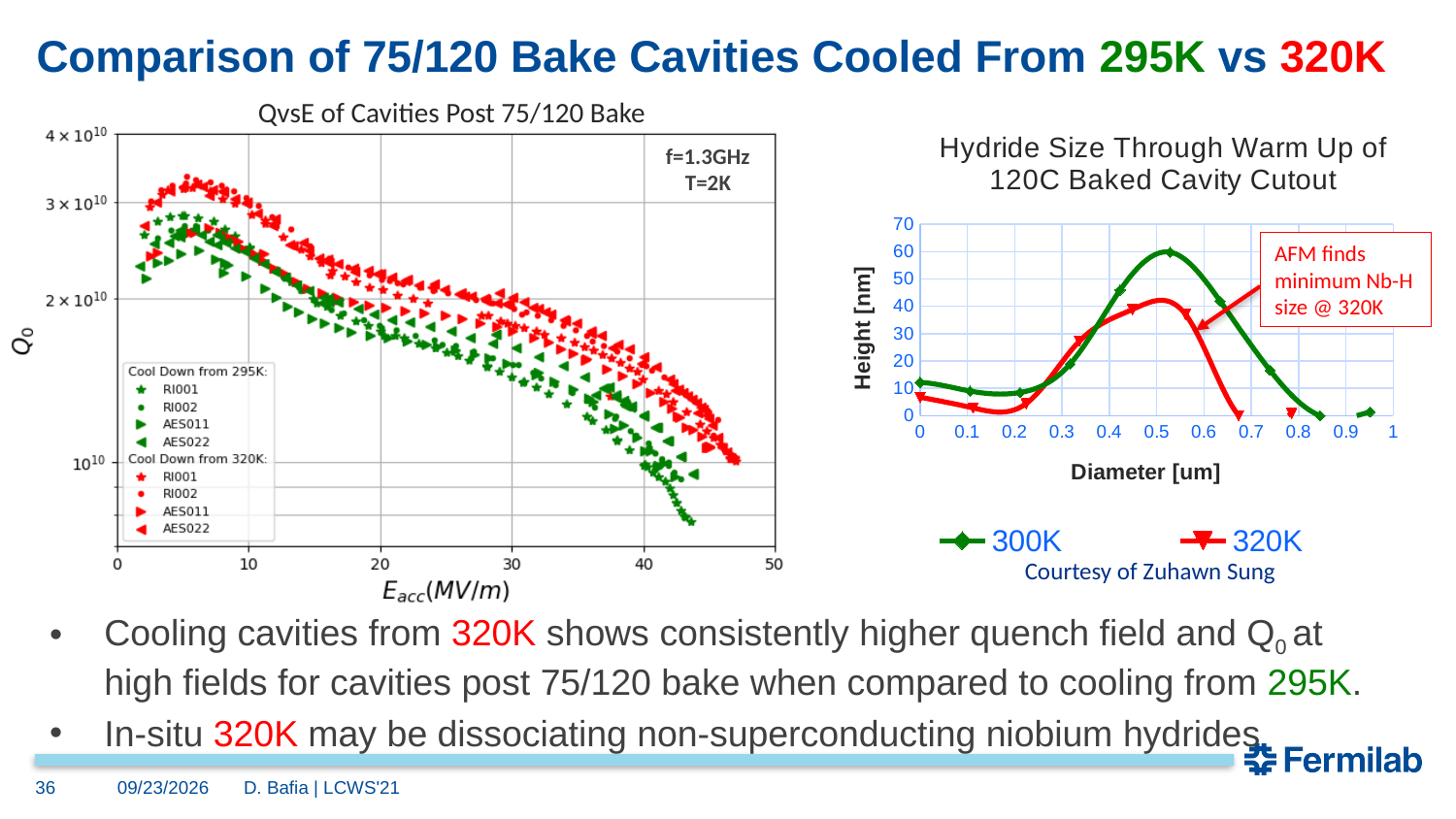
In the chart on the left titled 'QvsE of Cavities Post 75/120 Bake', what frequency and temperature are annotated on the plot? f=1.3GHz, T=2K In the chart on the right, what kind of chart is it? line chart In the chart on the right, does the 300K series rise or fall between diameters of 0.6 um and 0.8 um? fall In the chart on the right, is the height of the 320K series at a diameter of 0.7 um greater or less than 10? less In the chart on the right, is the peak height of the 320K series greater or less than 50? less In the chart on the right, what is the label of the x axis? Diameter [um] In the chart on the right, is the peak height of the 300K series greater or less than 50? greater In the chart on the left titled 'QvsE of Cavities Post 75/120 Bake', how many entries does the legend list in total? 8 In the chart on the right, which series reaches the higher peak height, 300K or 320K? 300K In the chart on the right, what is the label of the y axis? Height [nm] In the chart on the right, how many series does the legend list? 2